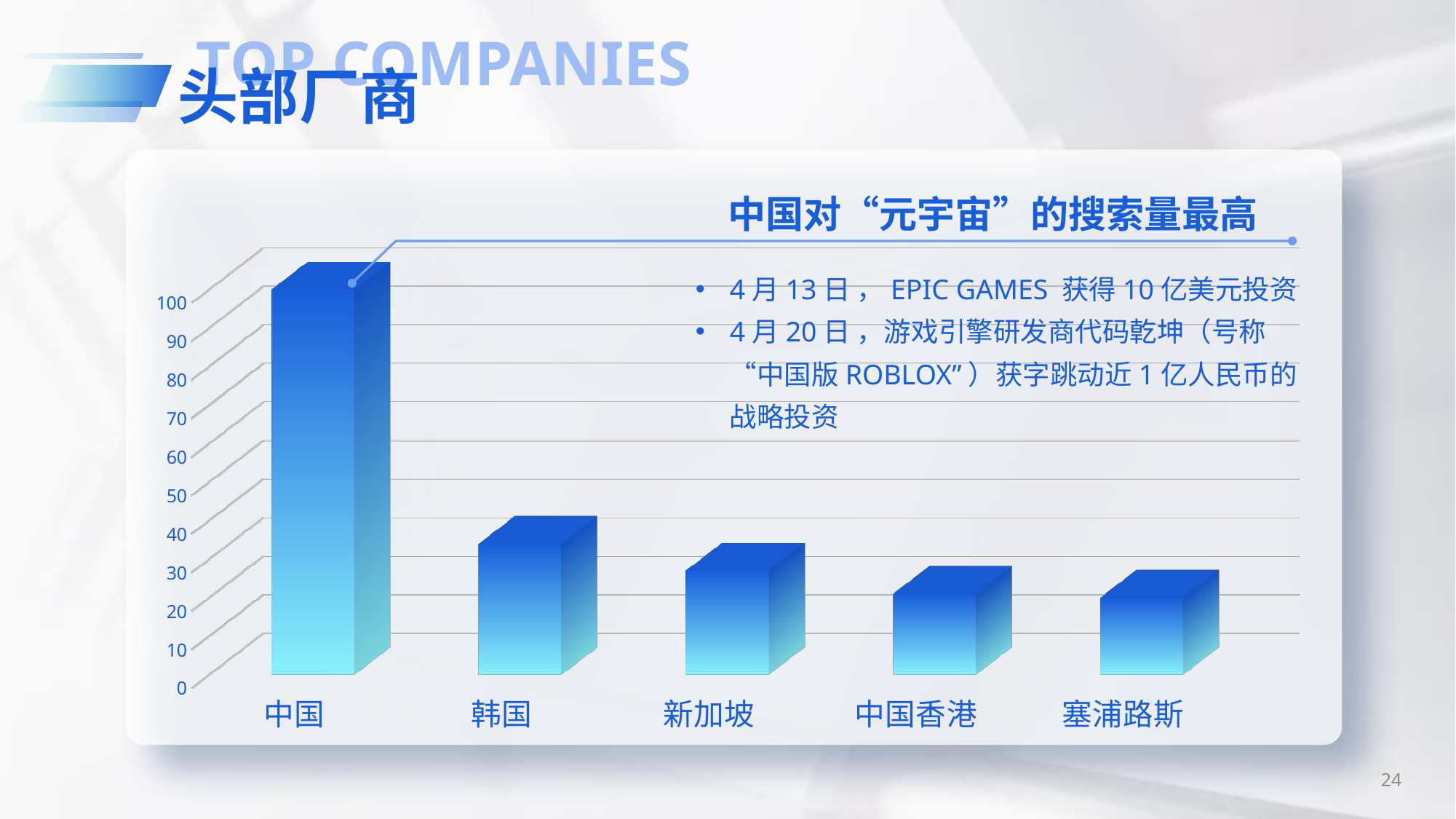
Is the value for 中国 greater or less than 90? greater Is the value for 中国香港 greater or less than 30? less Which has a larger value, 韩国 or 新加坡? 韩国 Is the value for 韩国 greater or less than 50? less Which category has the highest bar in the chart? 中国 How many categories are shown on the x axis of the chart? 5 What is the heading text shown above the bullet points next to the chart? 中国对“元宇宙”的搜索量最高 What kind of chart is shown on the slide? Bar chart Do the bar values rise or fall from left to right along the x axis? Fall